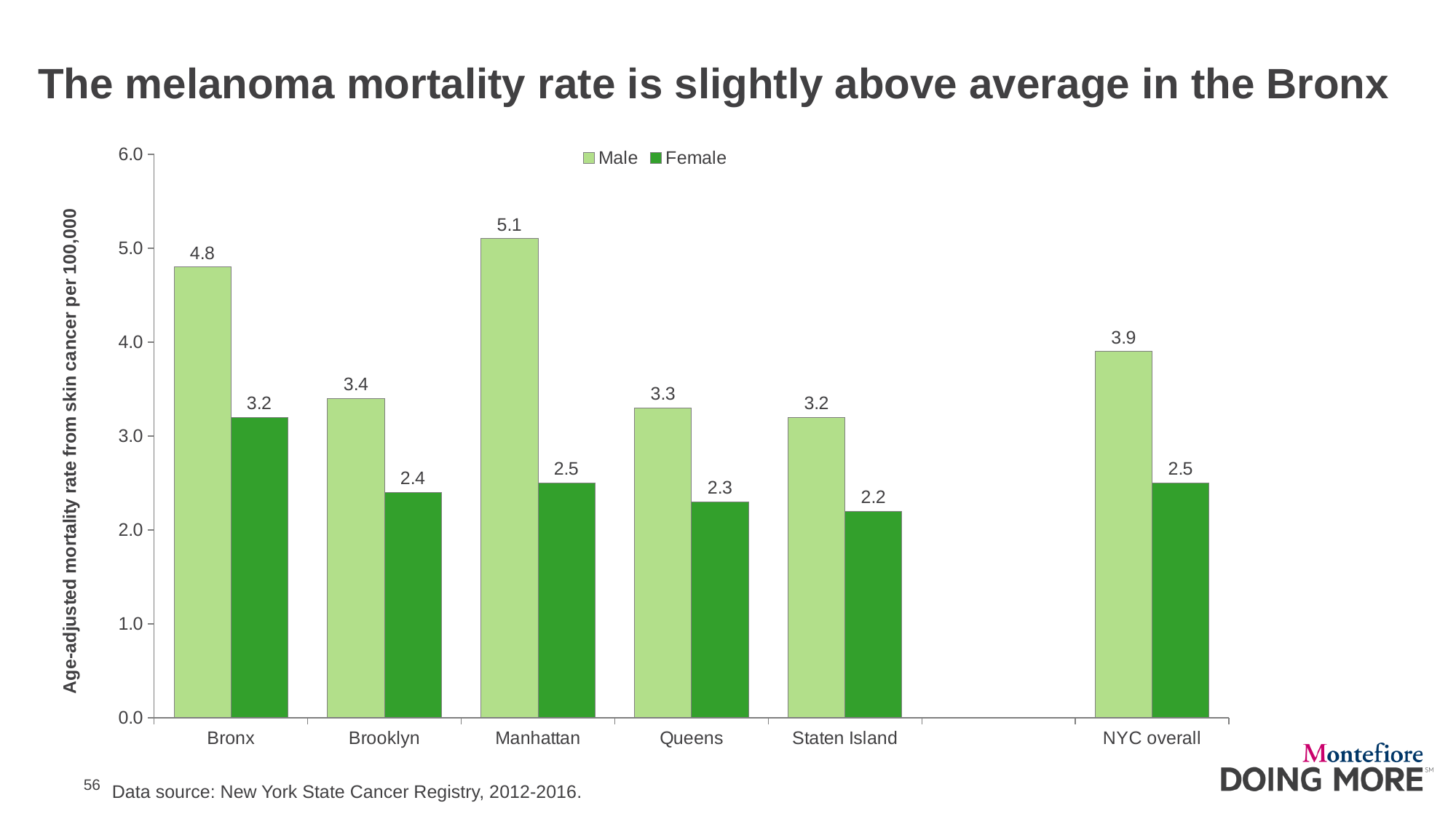
Which borough has the lowest female melanoma mortality rate? Staten Island What is the label of the vertical axis? Age-adjusted mortality rate from skin cancer per 100,000 How many categories are shown on the x axis? 6 What is the male melanoma mortality rate for NYC overall? 3.9 What is the female melanoma mortality rate in Queens? 2.3 What is the male melanoma mortality rate in the Bronx? 4.8 Is the female melanoma mortality rate higher in the Bronx or in Brooklyn? Bronx How many series does the legend list? 2 What kind of chart is shown on the slide? bar chart What is the difference between the male and female melanoma mortality rates in Manhattan? 2.6 Is the male melanoma mortality rate in Staten Island greater or less than 4.0? less Which borough has the highest male melanoma mortality rate? Manhattan